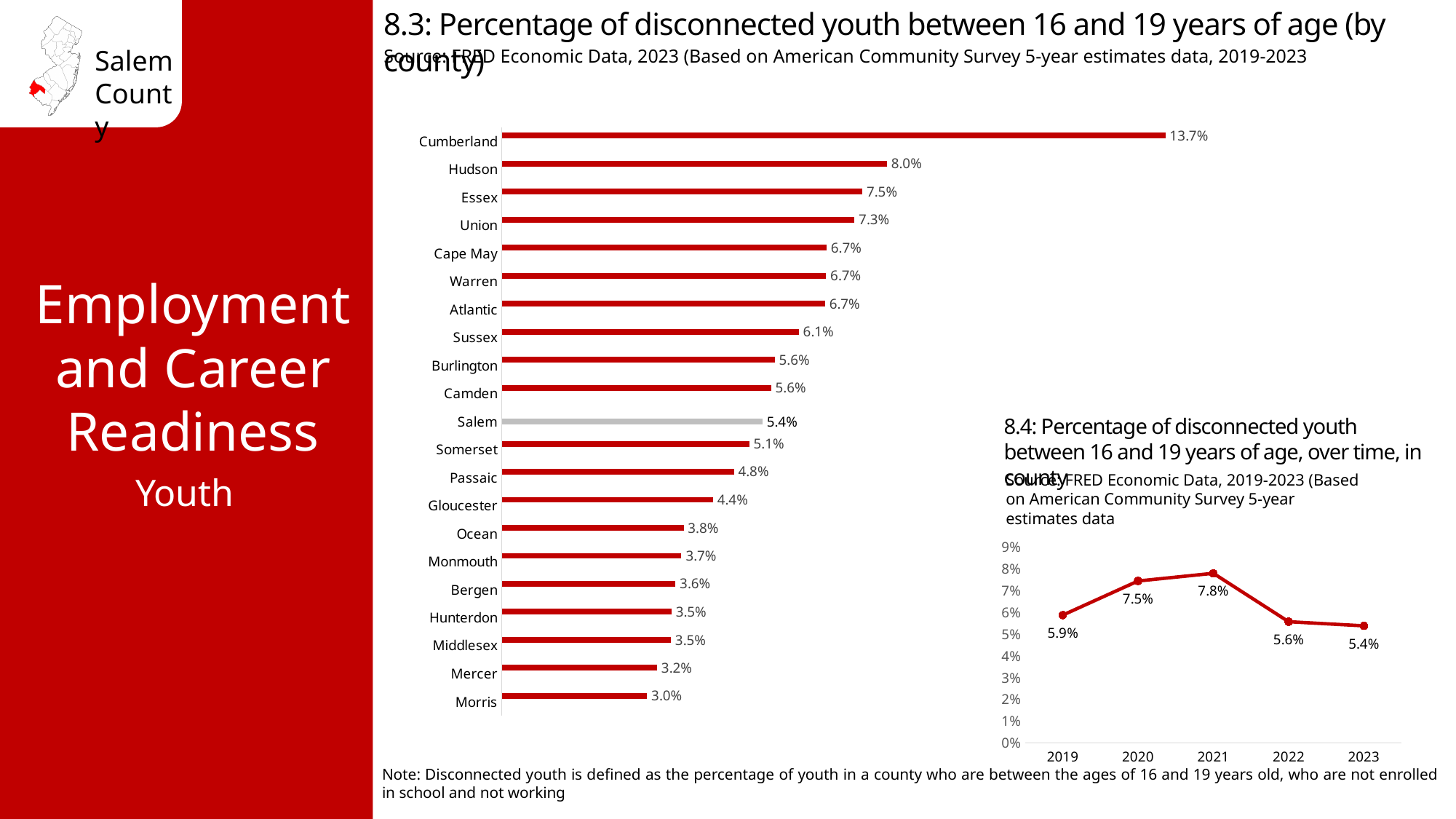
In the 8.3 bar chart (by county), how many counties are shown? 21 In the 8.3 bar chart (by county), which is larger, Gloucester or Passaic? Passaic In the 8.3 bar chart (by county), which county has the highest percentage of disconnected youth? Cumberland In the 8.4 line chart (over time), how many years are plotted? 5 In the 8.3 bar chart (by county), what is the difference between Cumberland and Salem? 8.3% In the 8.4 line chart (over time), what is the value for 2021? 7.8% What kind of chart is the 8.3 chart (by county)? Bar chart In the 8.3 bar chart (by county), which county has the lowest percentage of disconnected youth? Morris In the 8.3 bar chart (by county), what is the value for Salem? 5.4% In the 8.4 line chart (over time), which year has the lowest value? 2023 In the 8.4 line chart (over time), what is the difference between 2021 and 2023? 2.4% In the 8.3 bar chart (by county), what is the value for Hudson? 8.0%